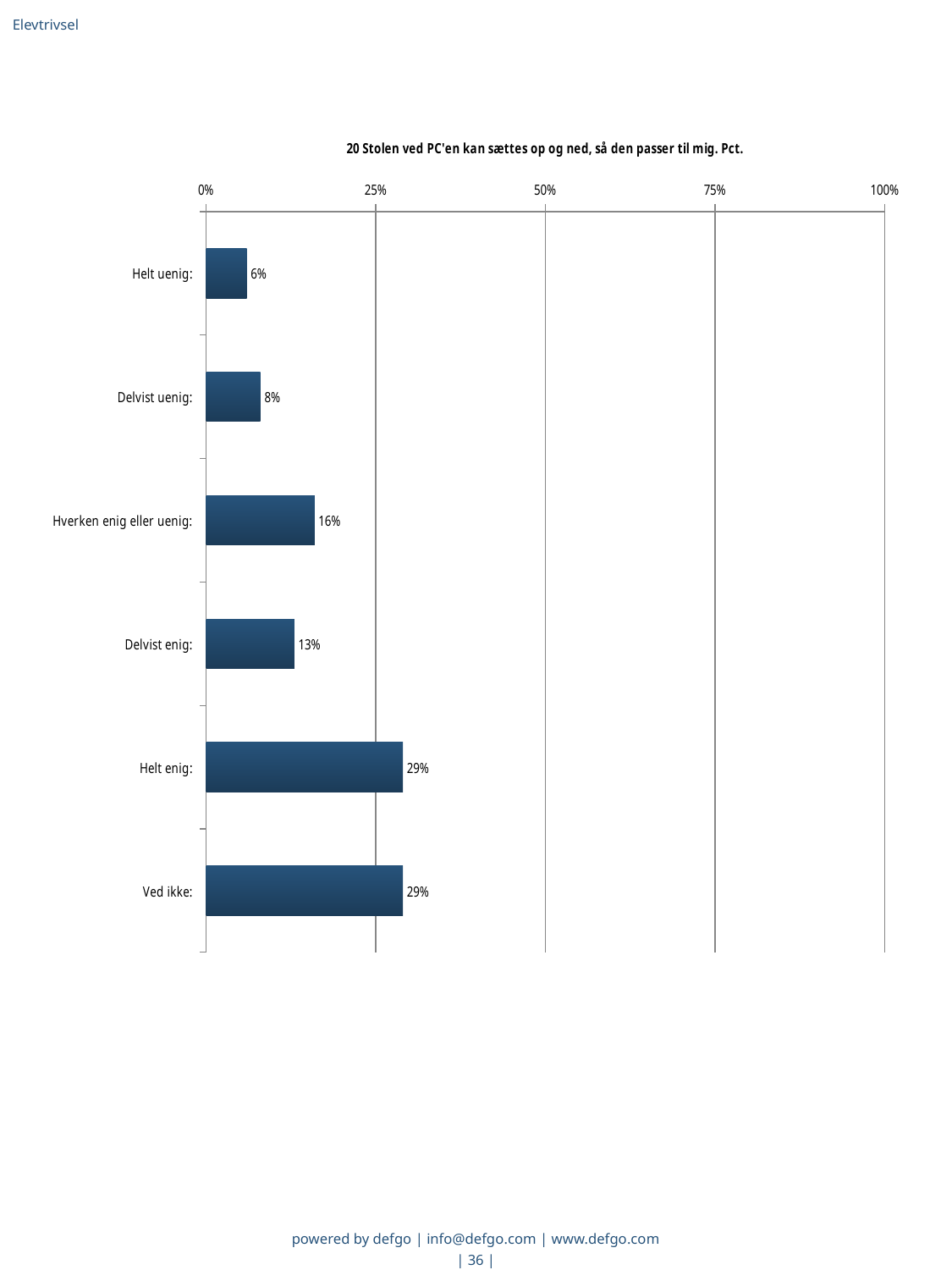
What is the value for Delvist enig? 13% Which is larger, the value for Hverken enig eller uenig or the value for Delvist enig? Hverken enig eller uenig What is the value for Helt uenig? 6% Which category has the lowest value? Helt uenig What is the difference between the values for Helt enig and Delvist uenig? 21% What is the value for Hverken enig eller uenig? 16% What is the value for Ved ikke? 29% What is the highest value shown on the x axis? 100% What is the title of the chart? 20 Stolen ved PC'en kan sættes op og ned, så den passer til mig. Pct. Is the value for Helt enig greater or less than 25%? greater What kind of chart is shown on the slide? Bar chart How many categories are shown in the chart? 6